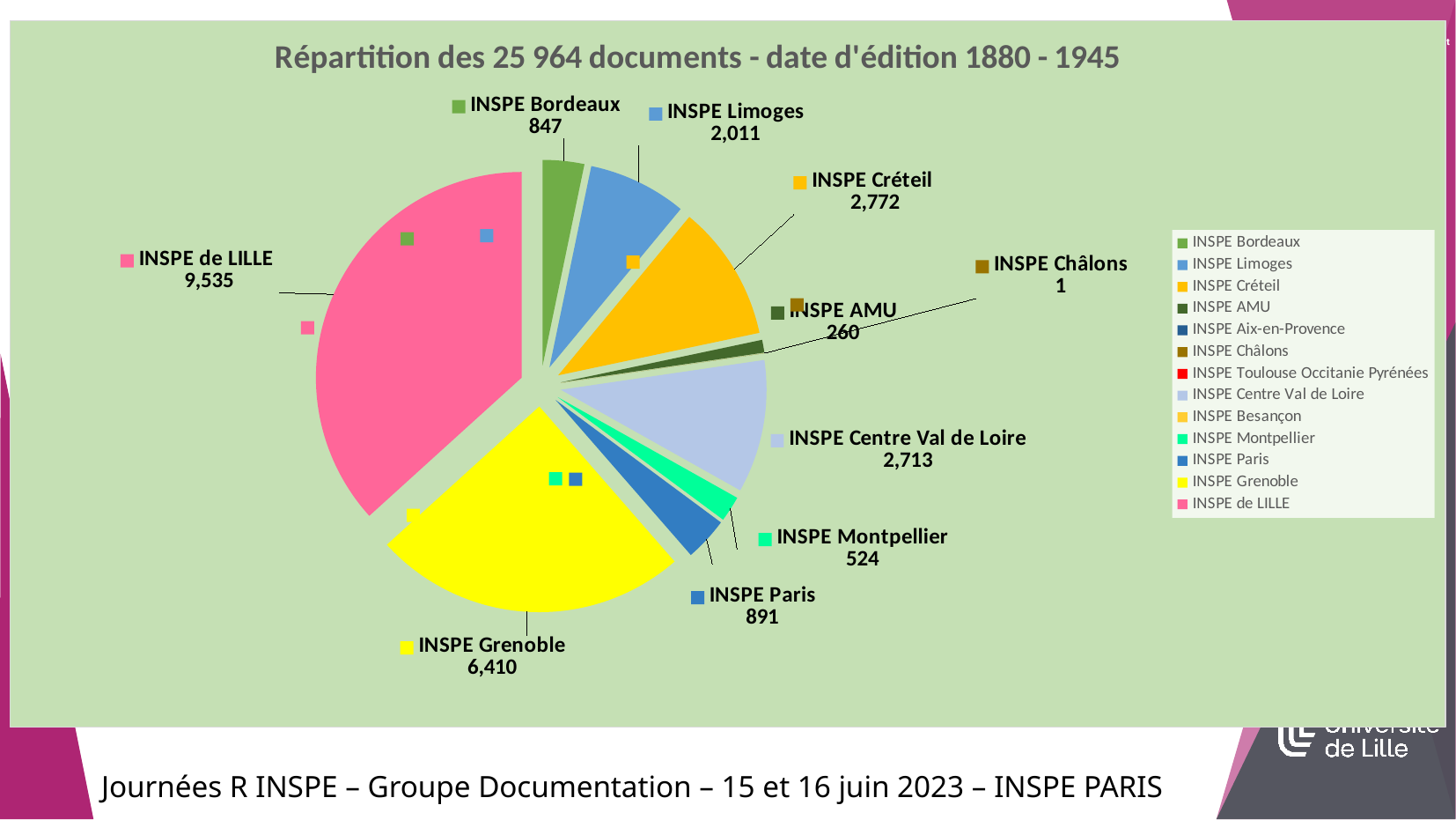
How many categories does the legend list? 13 What is the difference between the values for INSPE Créteil and INSPE Limoges? 761 What is the value for INSPE Grenoble? 6,410 What kind of chart is shown on the slide? Pie chart Which is larger, the value for INSPE Paris or the value for INSPE Montpellier? INSPE Paris What is the value for INSPE Châlons? 1 Which category has the largest slice of the pie? INSPE de LILLE What is the title of the chart? Répartition des 25 964 documents - date d'édition 1880 - 1945 What is the value for INSPE de LILLE? 9,535 What is the value for INSPE Centre Val de Loire? 2,713 What is the difference between the values for INSPE de LILLE and INSPE Grenoble? 3,125 Which is larger, the value for INSPE Créteil or the value for INSPE Limoges? INSPE Créteil